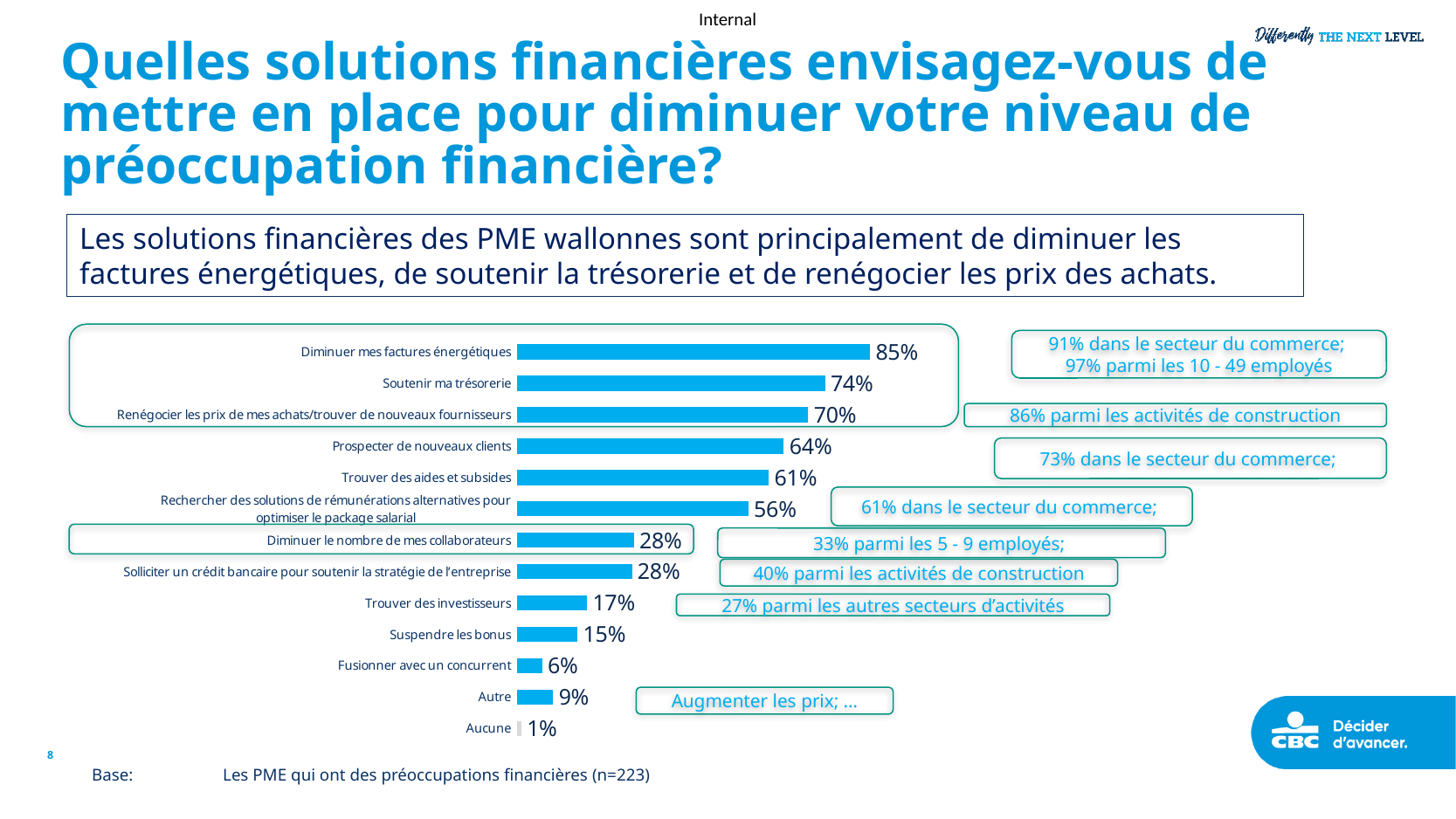
What percentage of respondents chose "Diminuer mes factures énergétiques"? 85% What is the value shown for "Soutenir ma trésorerie"? 74% Which category has the lowest value in the chart? Aucune What percentage is shown for "Trouver des aides et subsides"? 61% How many categories are shown in the chart? 13 Which is larger: the value for "Autre" or the value for "Fusionner avec un concurrent"? Autre Which category has the highest value in the chart? Diminuer mes factures énergétiques What kind of chart is shown on the slide? Bar chart What is the value for "Suspendre les bonus"? 15% Which two categories share the same value of 28%? Diminuer le nombre de mes collaborateurs; Solliciter un crédit bancaire pour soutenir la stratégie de l'entreprise What is the difference between the values for "Diminuer mes factures énergétiques" and "Soutenir ma trésorerie"? 11% What is the difference between "Prospecter de nouveaux clients" and "Trouver des investisseurs"? 47%